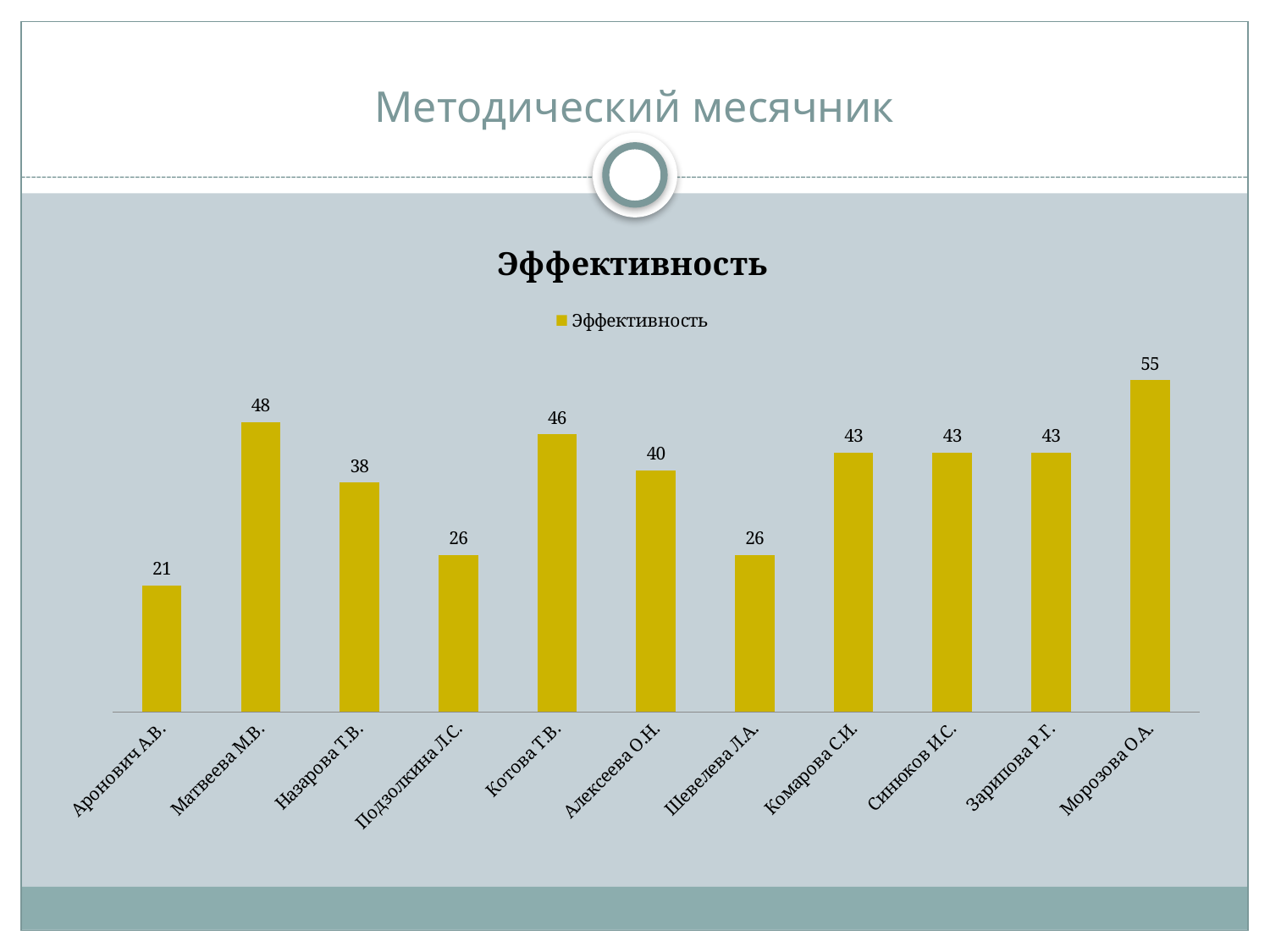
What is the difference between the values for Котова Т.В. and Назарова Т.В.? 8 How many series does the legend list? 1 What is the value for Матвеева М.В.? 48 Which is larger, the value for Матвеева М.В. or the value for Котова Т.В.? Матвеева М.В. What is the difference between the values for Морозова О.А. and Аронович А.В.? 34 What is the value for Подзолкина Л.С.? 26 Which category has the lowest value? Аронович А.В. Which category has the highest value? Морозова О.А. What is the value for Алексеева О.Н.? 40 What kind of chart is this? bar chart What is the title of the chart? Эффективность How many categories are shown on the x axis? 11